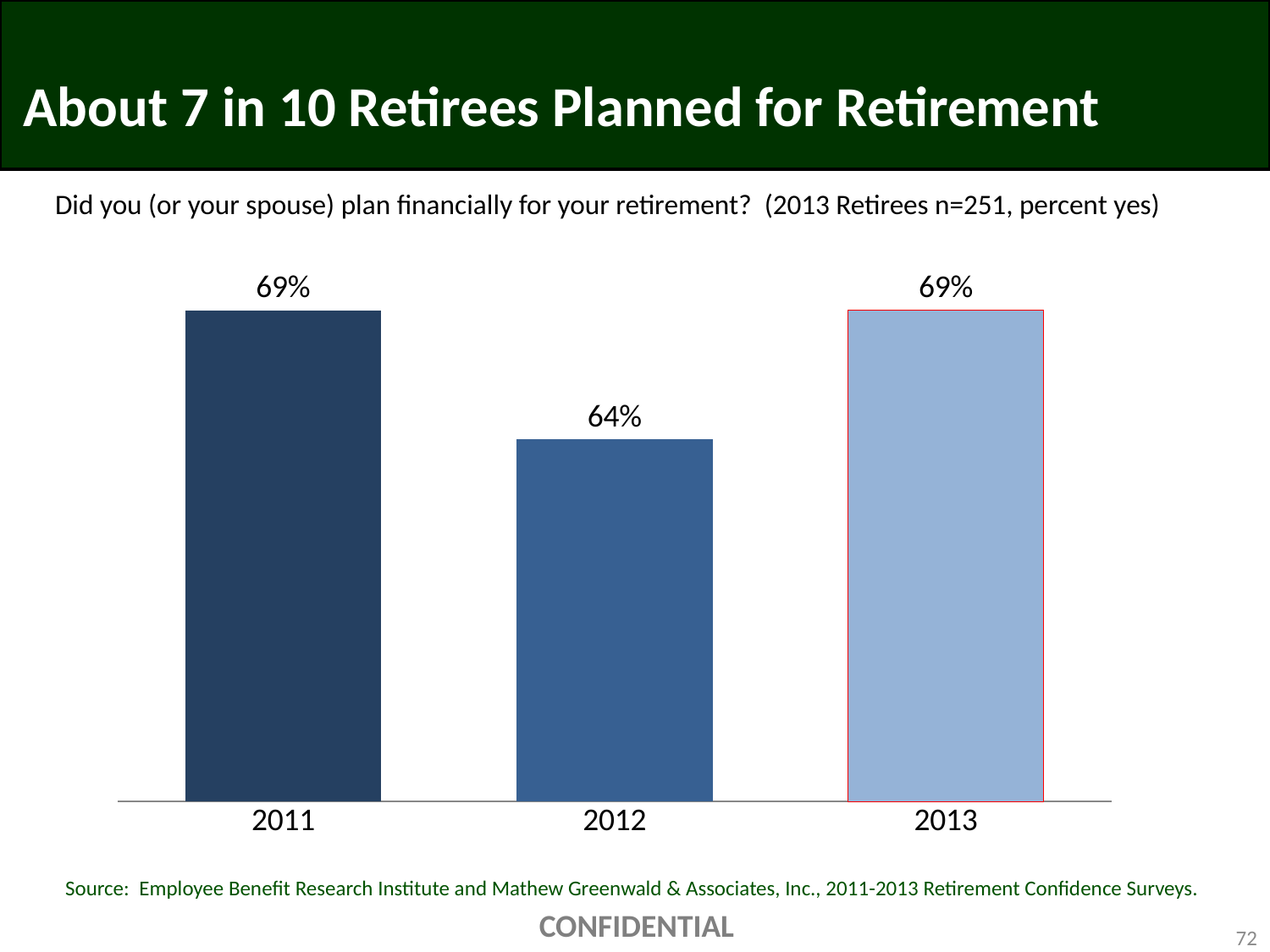
What is the difference between the values for 2013 and 2012? 5% Does the value rise or fall from 2012 to 2013? rise What is the value for 2011? 69% Does the value rise or fall from 2011 to 2012? fall What is the value for 2012? 64% Which year has the lowest value? 2012 What is the value for 2013? 69% Which bar has a red outline? 2013 What kind of chart is shown on the slide? bar chart Which is larger, the value for 2012 or the value for 2013? 2013 What is the difference between the values for 2011 and 2012? 5% How many years are shown on the x axis? 3